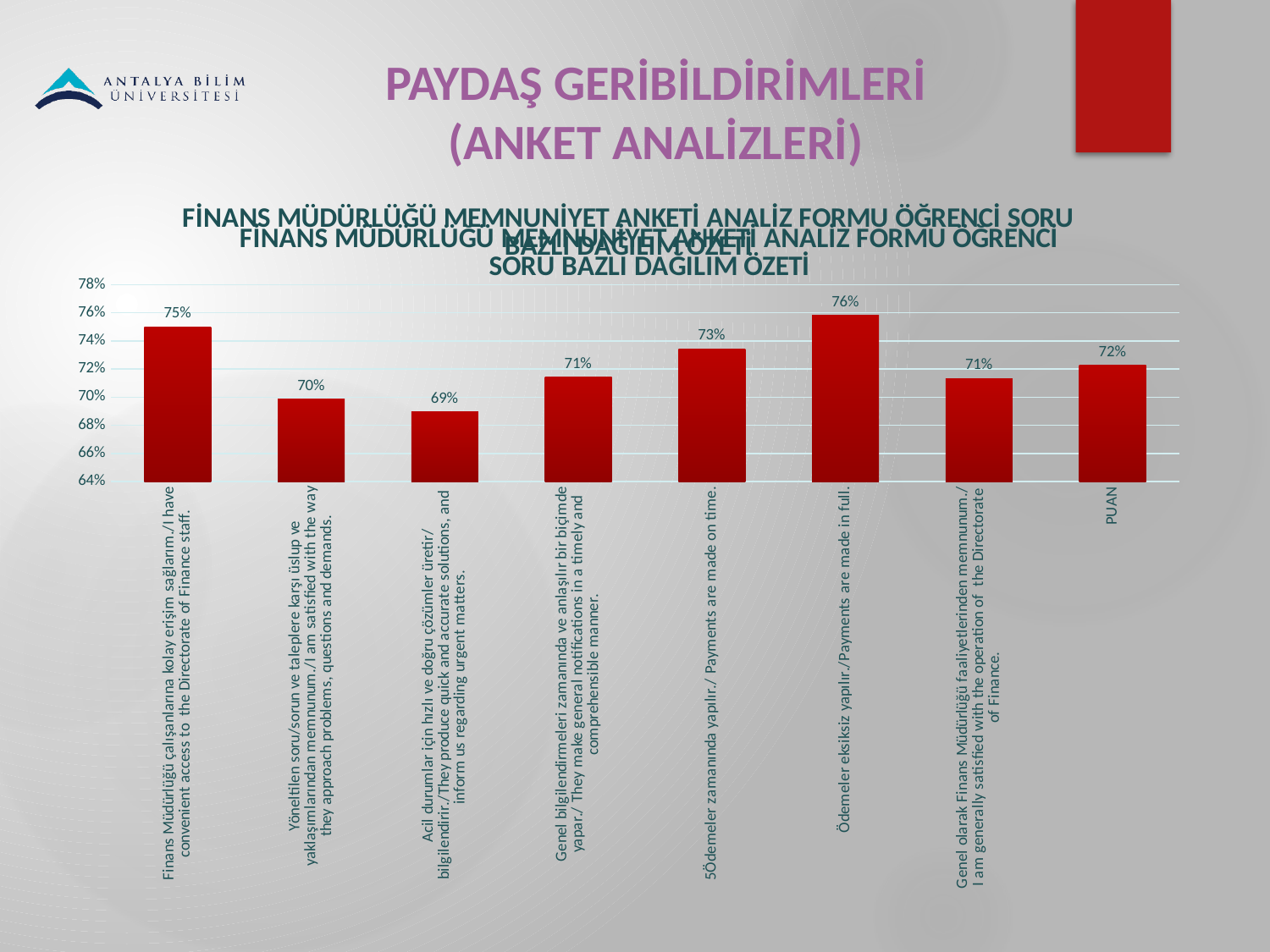
Which category has the highest value? Ödemeler eksiksiz yapılır./Payments are made in full. What is the value for the category about convenient access to the Directorate of Finance staff? 75% What colour are the bars in the chart? dark red What is the value for the category "Ödemeler zamanında yapılır./ Payments are made on time."? 73% How many bars are shown in the chart? 8 Which is larger: the value for "Payments are made on time" or the value for "PUAN"? Payments are made on time Which category has the lowest value? Acil durumlar için hızlı ve doğru çözümler üretir/ bilgilendirir./They produce quick and accurate solutions, and inform us regarding urgent matters. What kind of chart is shown on the slide? bar chart What is the value for the category "Ödemeler eksiksiz yapılır./Payments are made in full."? 76% What is the difference between the highest value (76%) and the lowest value (69%)? 7% What is the value for the category "PUAN"? 72% Is the value for "Payments are made in full" greater or less than 74%? greater